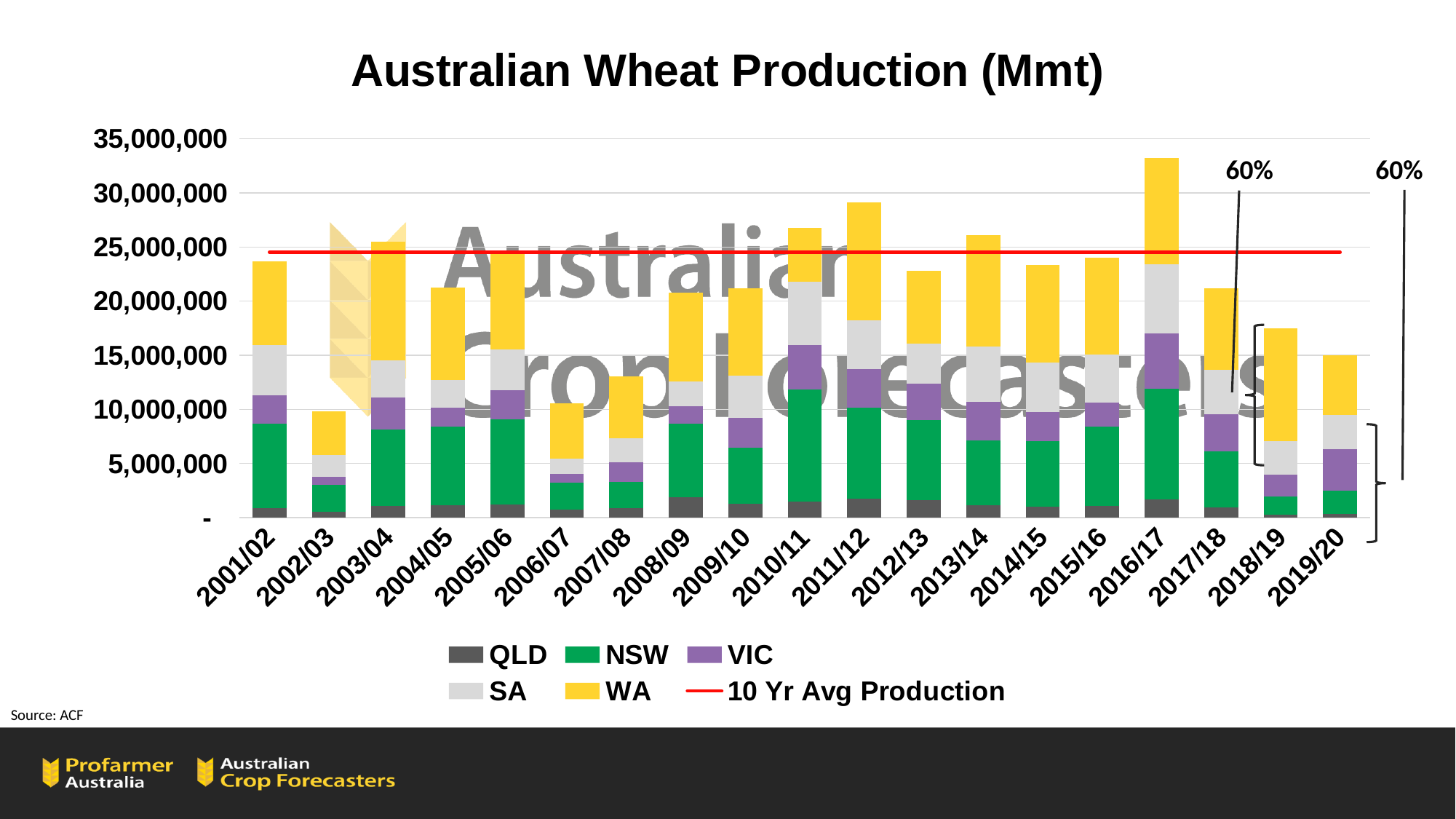
Is the total production for 2016/17 greater or less than 30,000,000? greater How many entries does the legend list? 6 Which season has the larger total production, 2003/04 or 2004/05? 2003/04 How many seasons (categories) are shown on the x axis? 19 Is the total production for 2019/20 greater or less than 20,000,000? less Is the total production for 2011/12 greater or less than 25,000,000? greater What kind of chart is shown on the slide? Stacked bar chart Which season has the larger total production, 2017/18 or 2018/19? 2017/18 Do total production values rise or fall from 2016/17 to 2019/20? fall Which season has the highest total wheat production? 2016/17 What is the title of the chart? Australian Wheat Production (Mmt) Which season has the lowest total wheat production? 2002/03